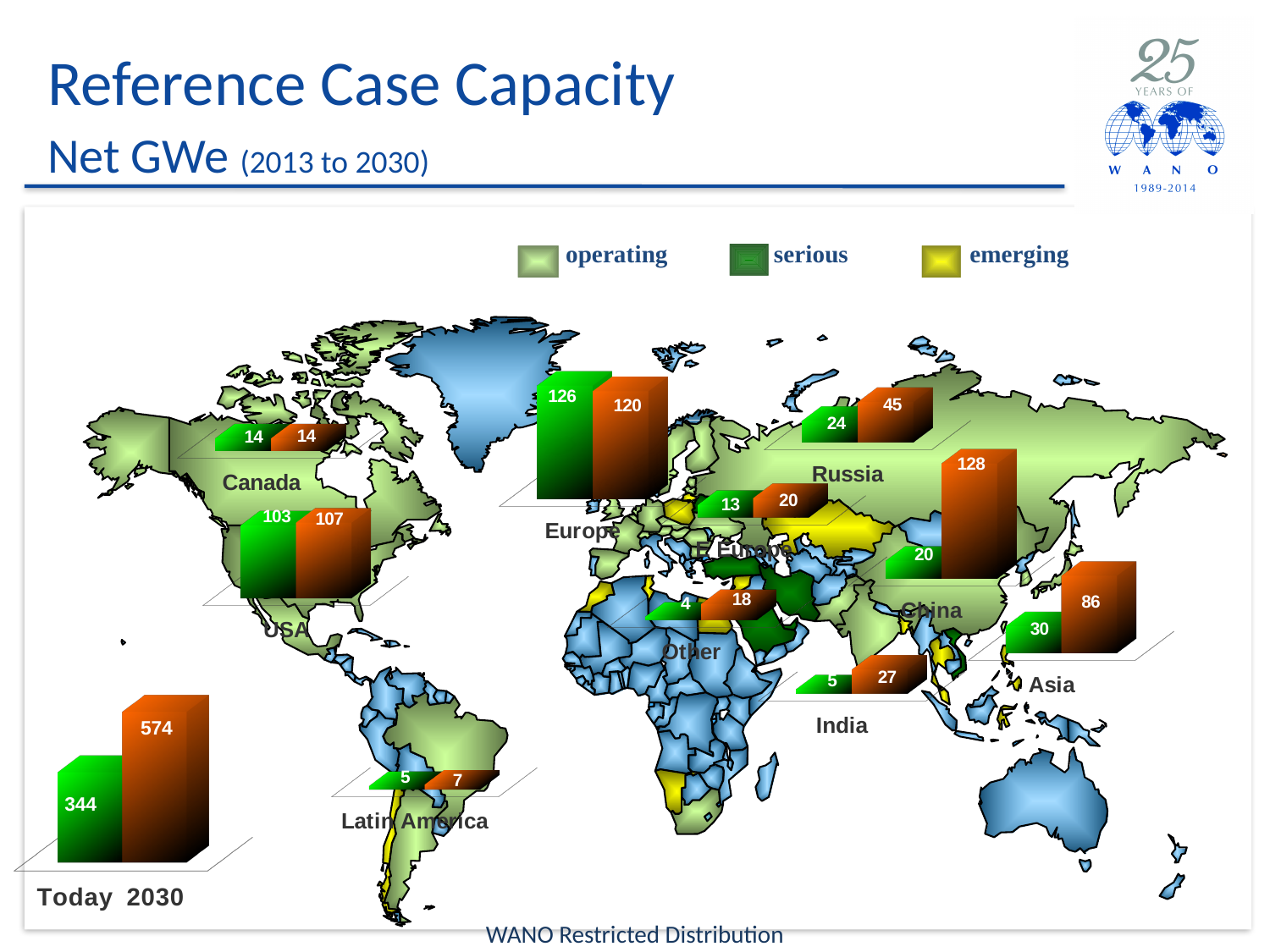
Across the regional charts, which region has the lowest Today value? Other On the Russia chart, which is larger, the Today value or the 2030 value? 2030 On the China chart, what is the value for 2030? 128 On the world total chart at the bottom left, what is the value for 2030? 574 On the Europe chart, what is the value for Today? 126 Across the regional charts, which region has the highest 2030 value? China On the USA chart, what is the value for Today? 103 On the Europe chart, which is larger, the Today value or the 2030 value? Today What kind of chart is used for each region on the map? Bar chart On the China chart, what is the difference between the 2030 value and the Today value? 108 On the USA chart, what is the value for 2030? 107 On the world total chart at the bottom left, what is the difference between the 2030 value and the Today value? 230